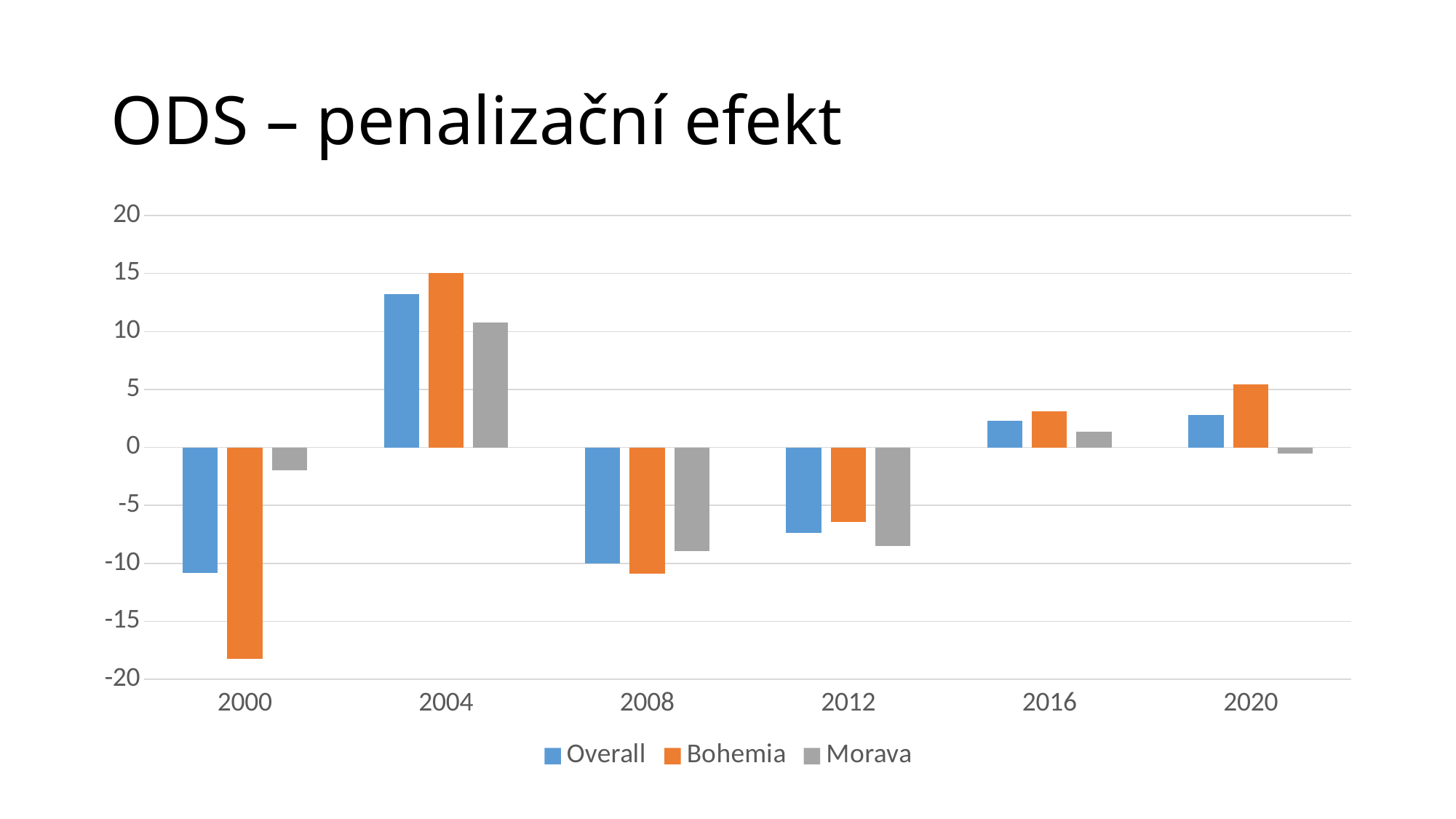
In 2004, which is larger: the Bohemia value or the Morava value? Bohemia In which year is the Overall value highest? 2004 What kind of chart is shown on the slide? bar chart Is the Morava value for 2008 greater or less than -5? less In which year is the Bohemia value lowest? 2000 Is the Overall value for 2004 greater or less than 10? greater In which year is the Bohemia value highest? 2004 Is the Bohemia value for 2000 greater or less than -15? less In 2000, which is lower: the Overall value or the Morava value? Overall How many years are shown on the x axis? 6 How many series does the legend list? 3 What is the title of the slide? ODS – penalizační efekt